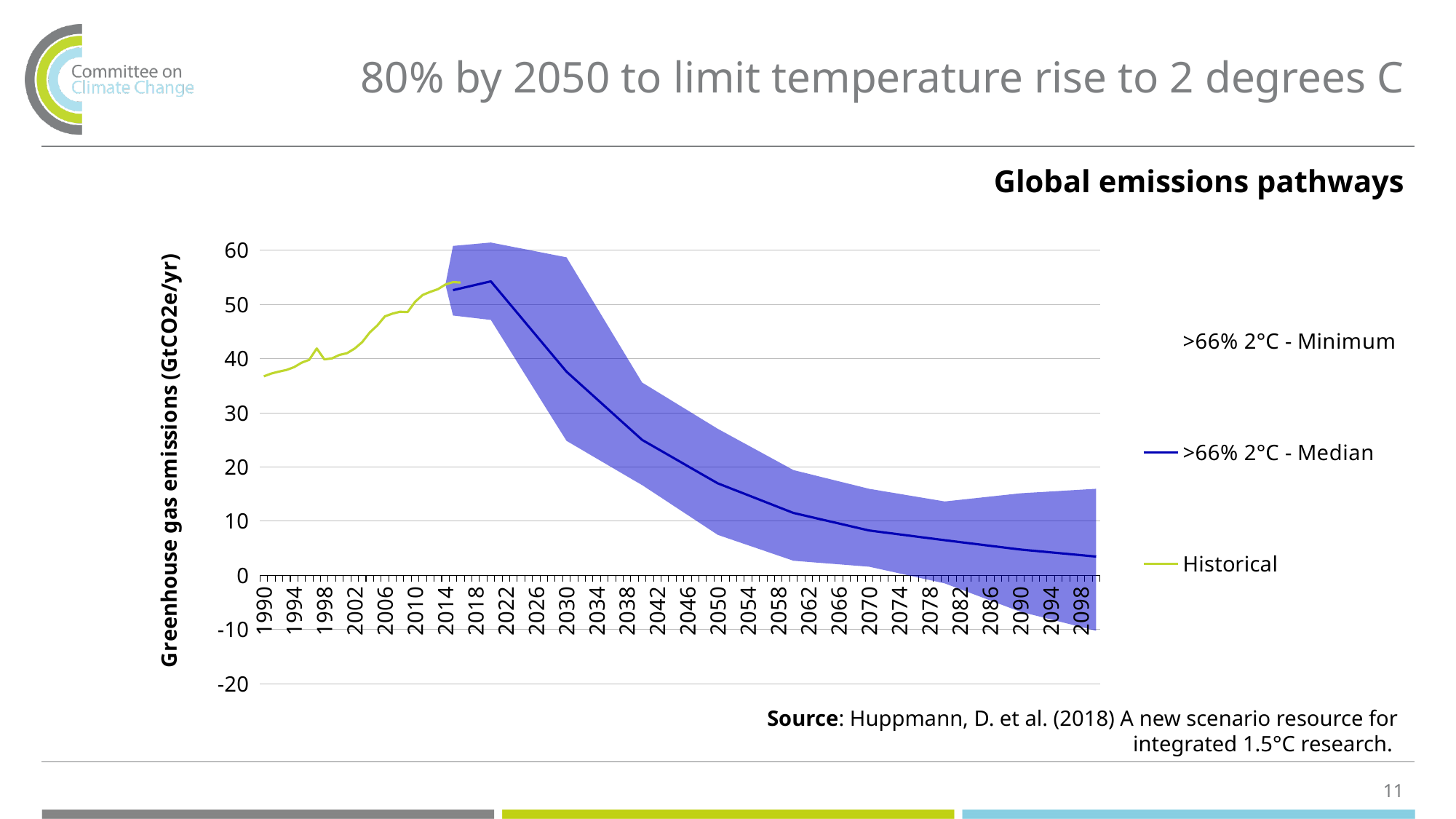
What kind of chart is shown on the slide? combination area and line chart What is the label of the vertical axis? Greenhouse gas emissions (GtCO2e/yr) How many series does the chart legend list? 3 Does the Historical series rise or fall between 1990 and 2014? rise Is the Historical value in 2014 greater or less than 50? greater Which is larger for the Historical series: the value in 1990 or the value in 2014? 2014 What is the title of the chart? Global emissions pathways Is the >66% 2°C - Median value in 2098 greater or less than 10? less Is the >66% 2°C - Median value in 2050 greater or less than 20? less Does the >66% 2°C - Median series rise or fall between 2018 and 2098? fall Which is larger for the >66% 2°C - Median series: the value in 2030 or the value in 2050? 2030